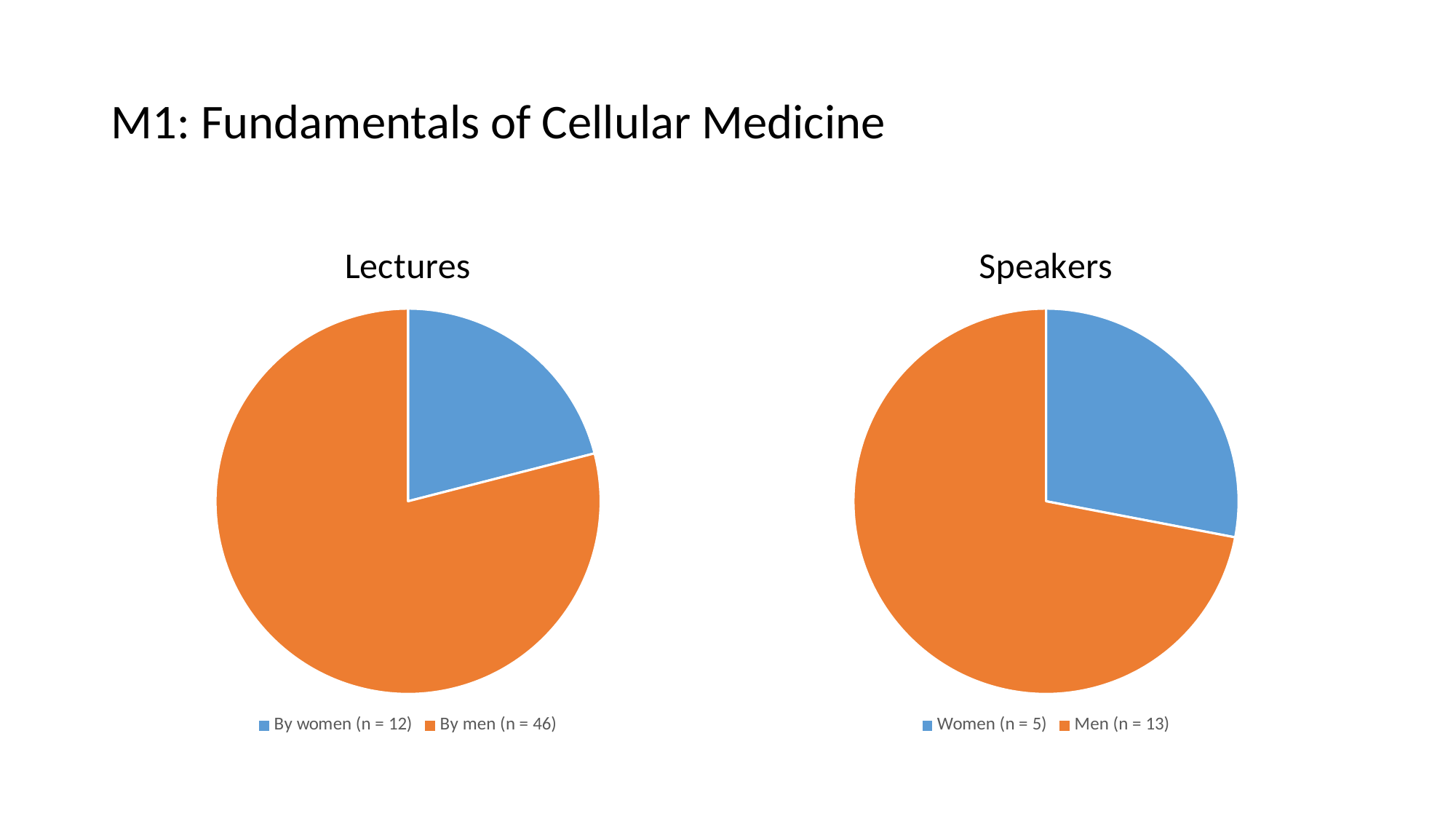
What type of chart is the Lectures chart? pie chart In the Lectures chart, which category has the largest slice? By men (n = 46) How many slices does the Lectures pie chart have? 2 In the Speakers chart, how many speakers were women? 5 In the Lectures chart, how many lectures were given by women? 12 In the Speakers chart, what is the total number of speakers across both slices? 18 In the Speakers chart, what is the difference between the number of men and women speakers? 8 In the Speakers chart, how many speakers were men? 13 In the Lectures chart, how many lectures were given by men? 46 In the Lectures chart, what is the difference between the number of lectures by men and by women? 34 In the Speakers chart, which colour represents men? orange In the Speakers chart, which category has the smallest slice? Women (n = 5)